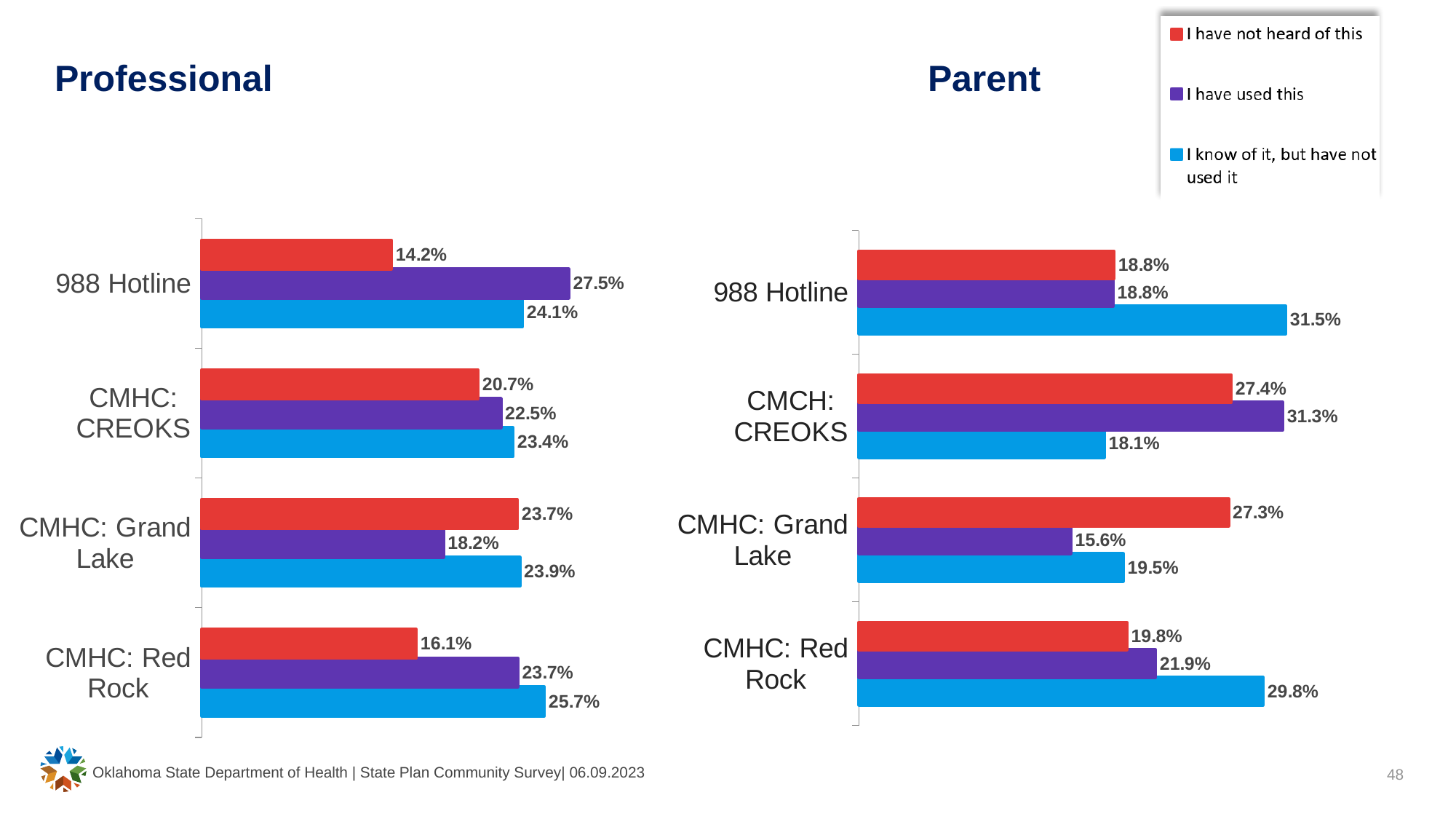
In the Professional chart, what is the value for 'I have used this' for 988 Hotline? 27.5% In the Parent chart, which category has the lowest value for 'I have used this'? CMHC: Grand Lake In the Parent chart, which is larger for CMHC: Red Rock: 'I have used this' or 'I know of it, but have not used it'? I know of it, but have not used it In the Professional chart, which category has the highest value for 'I have not heard of this'? CMHC: Grand Lake In the Professional chart, what is the difference between 'I have used this' and 'I have not heard of this' for 988 Hotline? 13.3% In the Parent chart, what is the difference between 'I have not heard of this' and 'I know of it, but have not used it' for CMCH: CREOKS? 9.3% In the Parent chart, what is the value for 'I know of it, but have not used it' for 988 Hotline? 31.5% In the Parent chart, what is the value for 'I have not heard of this' for CMHC: Grand Lake? 27.3% What kind of chart is the Parent chart? Bar chart How many series does the legend list? 3 How many categories are shown in the Professional chart? 4 In the Professional chart, what is the value for 'I have not heard of this' for CMHC: Red Rock? 16.1%